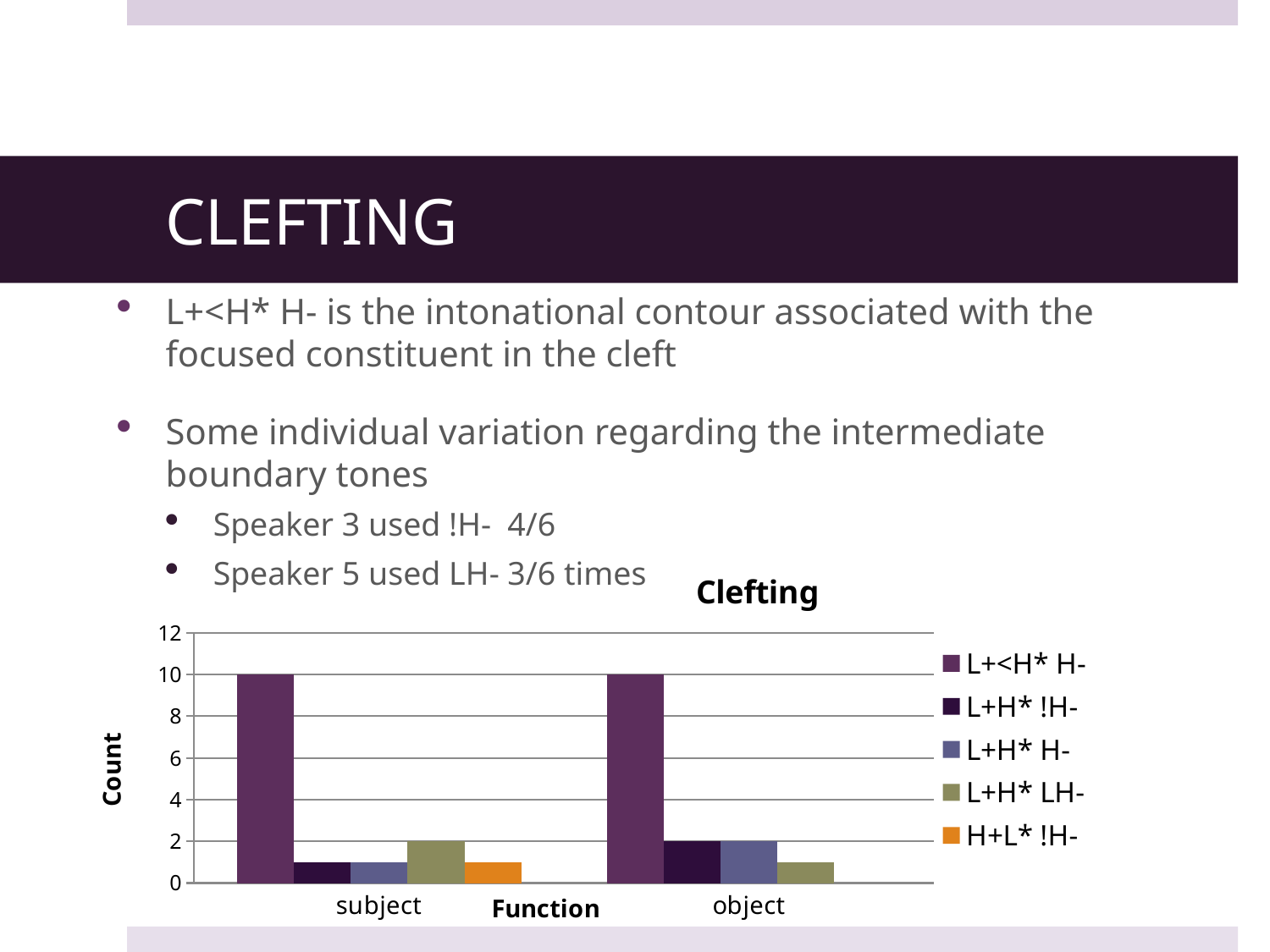
For L+H* LH-, which category has the larger count, subject or object? subject What is the count for L+H* !H- in the object category? 2 What is the title of the y axis of the Clefting chart? Count What is the count for L+<H* H- in the subject category? 10 Which series has the highest count in the subject category? L+<H* H- What is the difference between the counts for L+<H* H- and L+H* LH- in the subject category? 8 How many series does the legend of the Clefting chart list? 5 What kind of chart is shown on the slide? bar chart How many categories are shown on the x axis of the Clefting chart? 2 Is the count for L+H* !H- in the subject category greater or less than 2? less What is the count for L+H* LH- in the subject category? 2 What is the count for L+<H* H- in the object category? 10